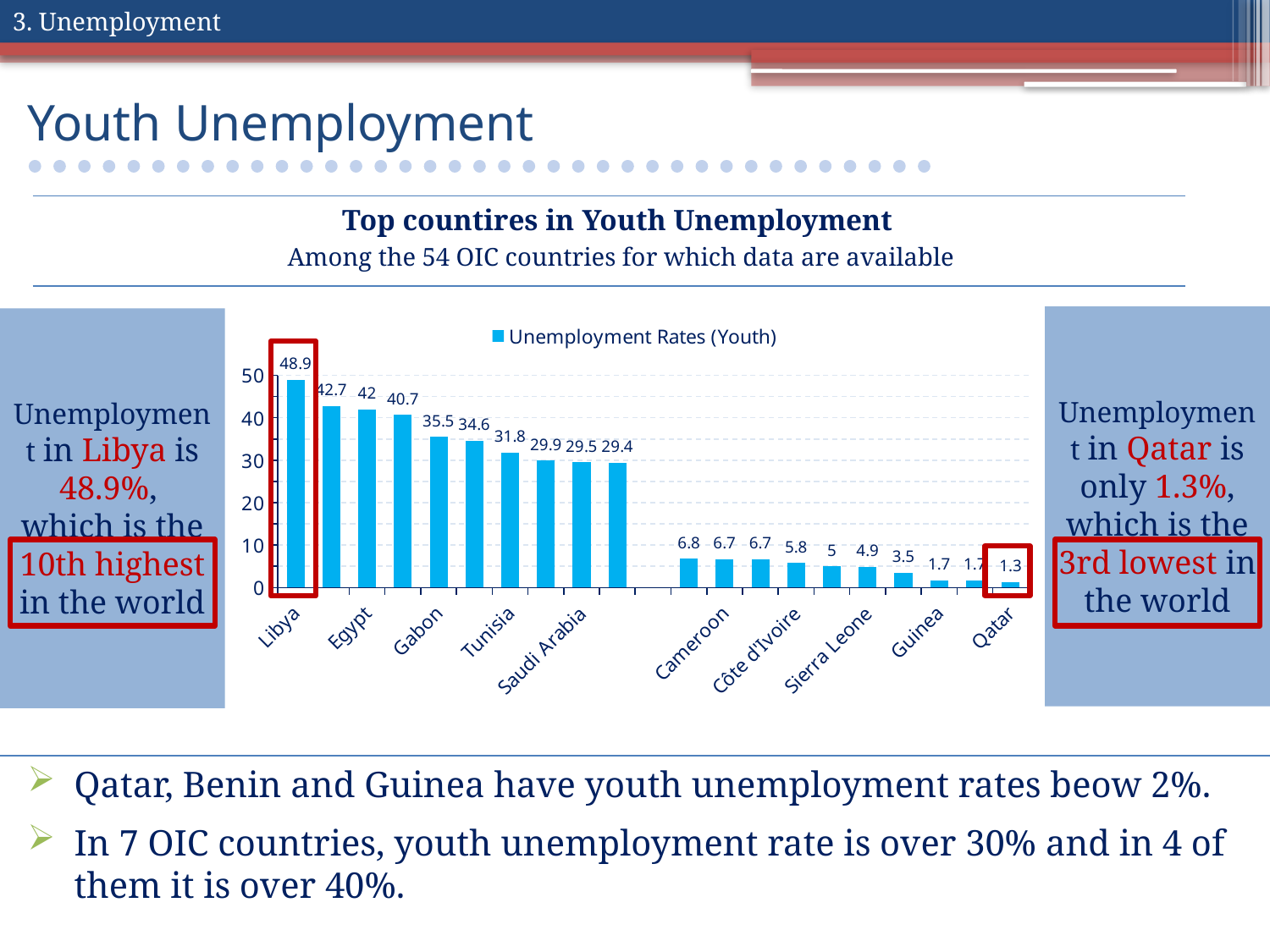
What type of chart is shown on the slide? bar chart Which country has the highest youth unemployment rate in the chart? Libya What is the youth unemployment rate for Qatar? 1.3 Which country has the lowest youth unemployment rate in the chart? Qatar What is the youth unemployment rate for Egypt? 42 Do the values rise or fall moving from left to right along the x axis? fall How many series does the legend list? 1 What is the youth unemployment rate for Libya? 48.9 What is the difference between the youth unemployment rates of Libya and Qatar? 47.6 Which has a higher youth unemployment rate, Egypt or Tunisia? Egypt What is the youth unemployment rate for Gabon? 35.5 Is the value for Gabon greater or less than 30? greater